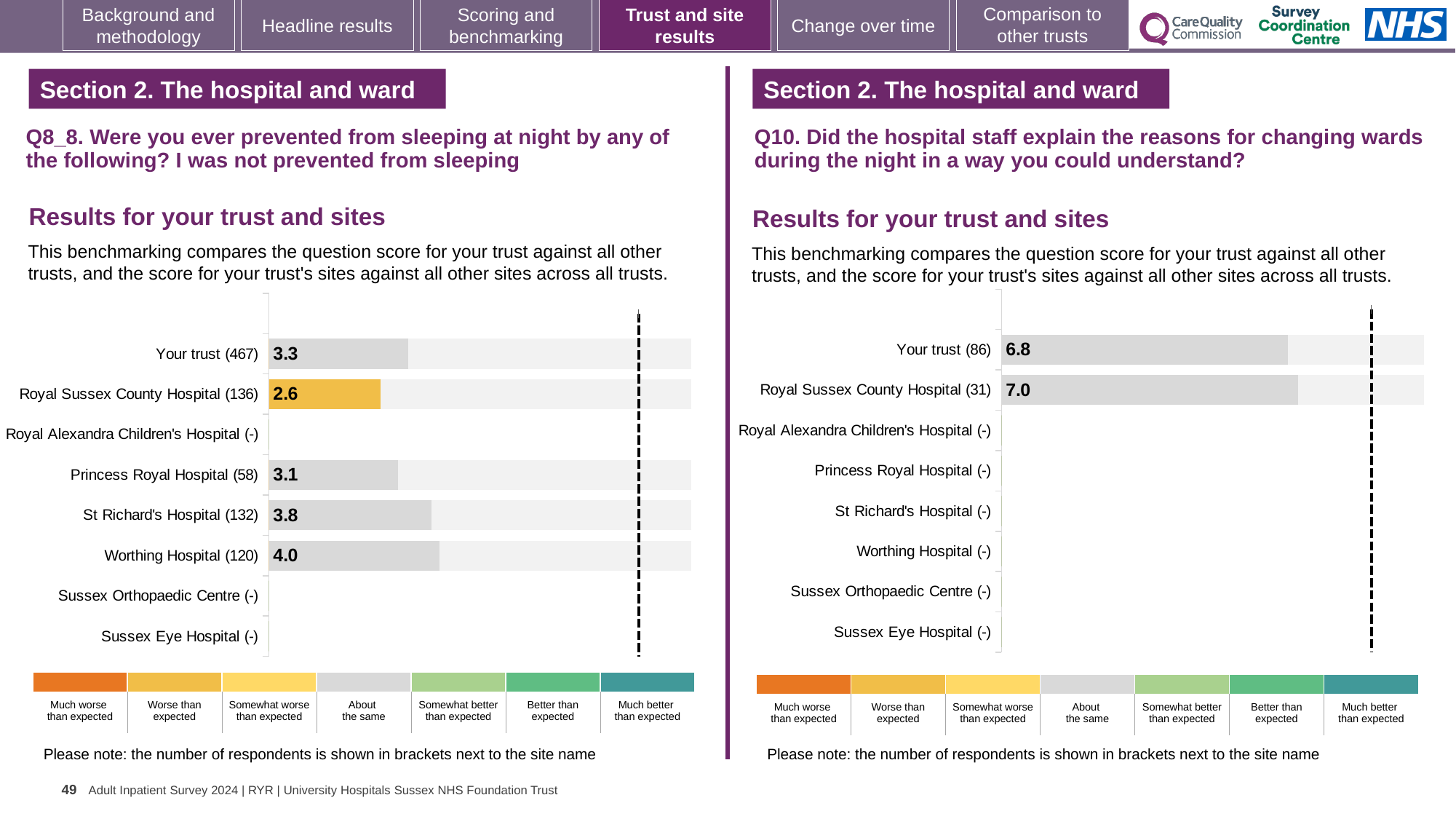
In the left chart (Q8_8), which benchmark category does the colour of the Royal Sussex County Hospital bar correspond to? Worse than expected In the right chart (Q10), how many sites have a plotted score (excluding Your trust)? 1 In the left chart (Q8_8), what is the score for Your trust? 3.3 In the right chart (Q10), what is the score for Your trust? 6.8 In the left chart (Q8_8), what is the score for Worthing Hospital? 4.0 In the left chart (Q8_8), what is the difference between the scores for St Richard's Hospital and Princess Royal Hospital? 0.7 In the left chart (Q8_8), which site with a plotted score has the lowest score? Royal Sussex County Hospital In the right chart (Q10), what is the score for Royal Sussex County Hospital? 7.0 In the left chart (Q8_8), which has the higher score, Princess Royal Hospital or St Richard's Hospital? St Richard's Hospital In the left chart (Q8_8), what is the score for Royal Sussex County Hospital? 2.6 What type of chart is used on the left side of the slide (Q8_8)? Bar chart In the left chart (Q8_8), which site with a plotted score has the highest score? Worthing Hospital